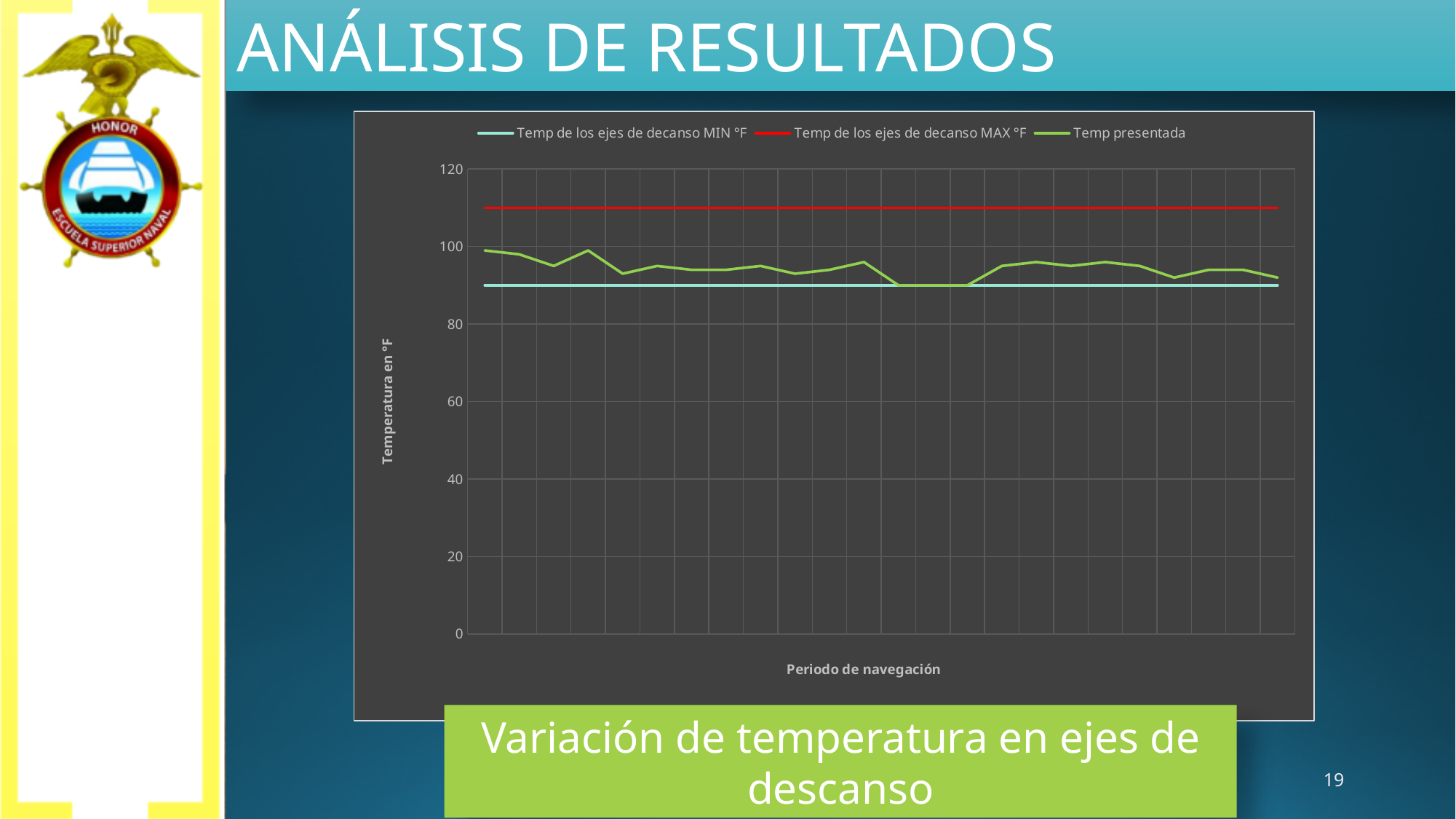
Is the value of the 'Temp de los ejes de decanso MAX °F' line greater or less than 100? greater Which series is plotted in red? Temp de los ejes de decanso MAX °F What is the title of the vertical axis of the chart? Temperatura en °F Is the value of the 'Temp de los ejes de decanso MIN °F' line greater or less than 80? greater Is the lowest value of the 'Temp presentada' line greater or less than 80? greater What kind of chart is shown on the slide? line chart How many series does the chart legend list? 3 What is the title of the horizontal axis of the chart? Periodo de navegación Does the 'Temp de los ejes de decanso MAX °F' line rise, fall, or stay flat along the x axis? stays flat Which line is higher on the chart, 'Temp de los ejes de decanso MAX °F' or 'Temp de los ejes de decanso MIN °F'? Temp de los ejes de decanso MAX °F